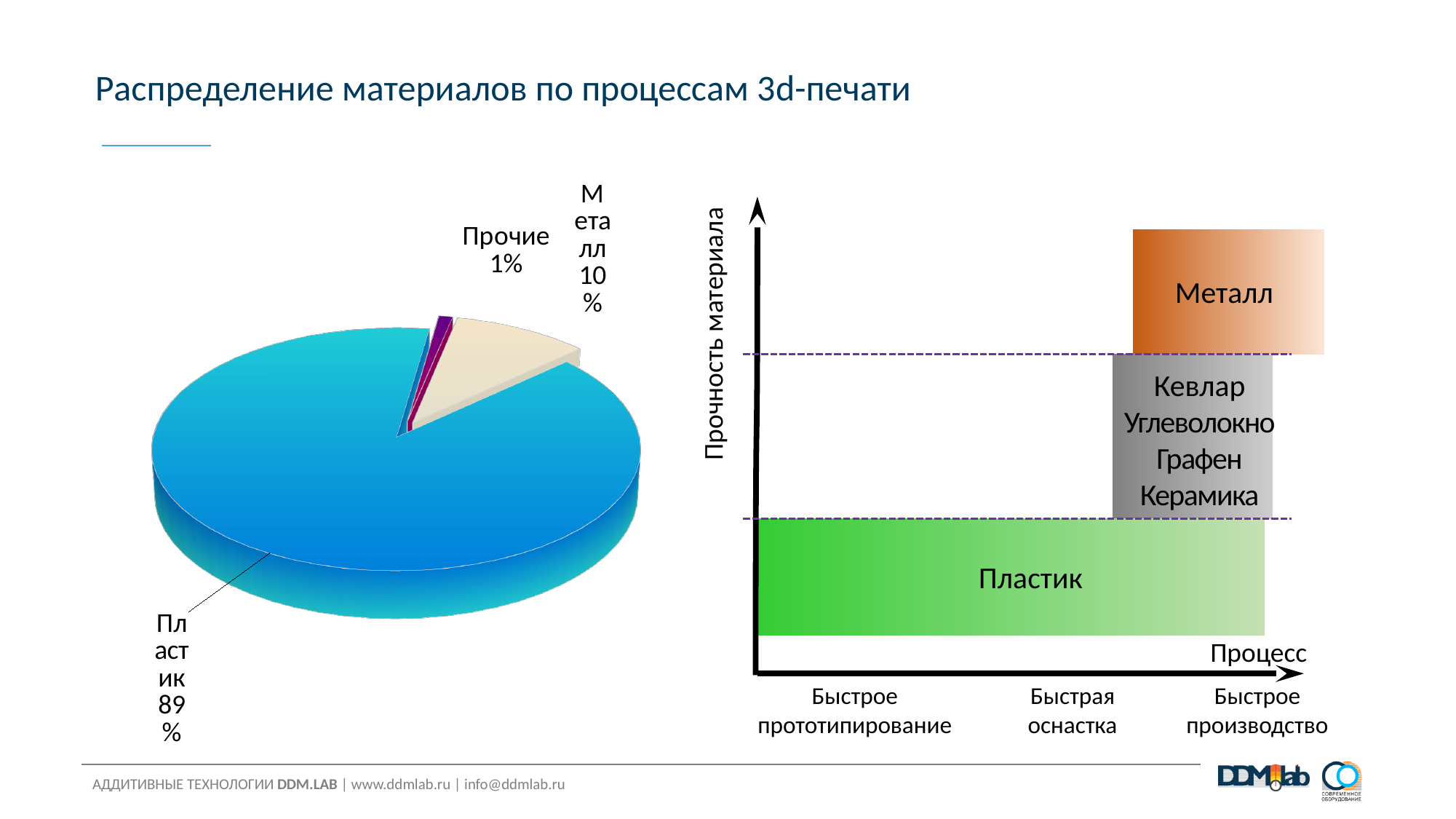
What is the title of the slide? Распределение материалов по процессам 3d-печати In the pie chart on the left, which is larger: Металл or Прочие? Металл In the pie chart on the left, what share is shown for Прочие? 1% In the pie chart on the left, which category has the largest share? Пластик What kind of chart is shown on the left side of the slide? Pie chart In the pie chart on the left, what share is shown for Пластик? 89% In the pie chart on the left, what is the difference in percentage points between Пластик and Металл? 79 In the pie chart on the left, what share is shown for Металл? 10% In the pie chart on the left, which labelled category has the smallest share? Прочие In the pie chart on the left, how many categories have labels? 3 In the diagram on the right, which material is placed at the top of the vertical axis Прочность материала? Металл In the pie chart on the left, what is the difference in percentage points between Металл and Прочие? 9